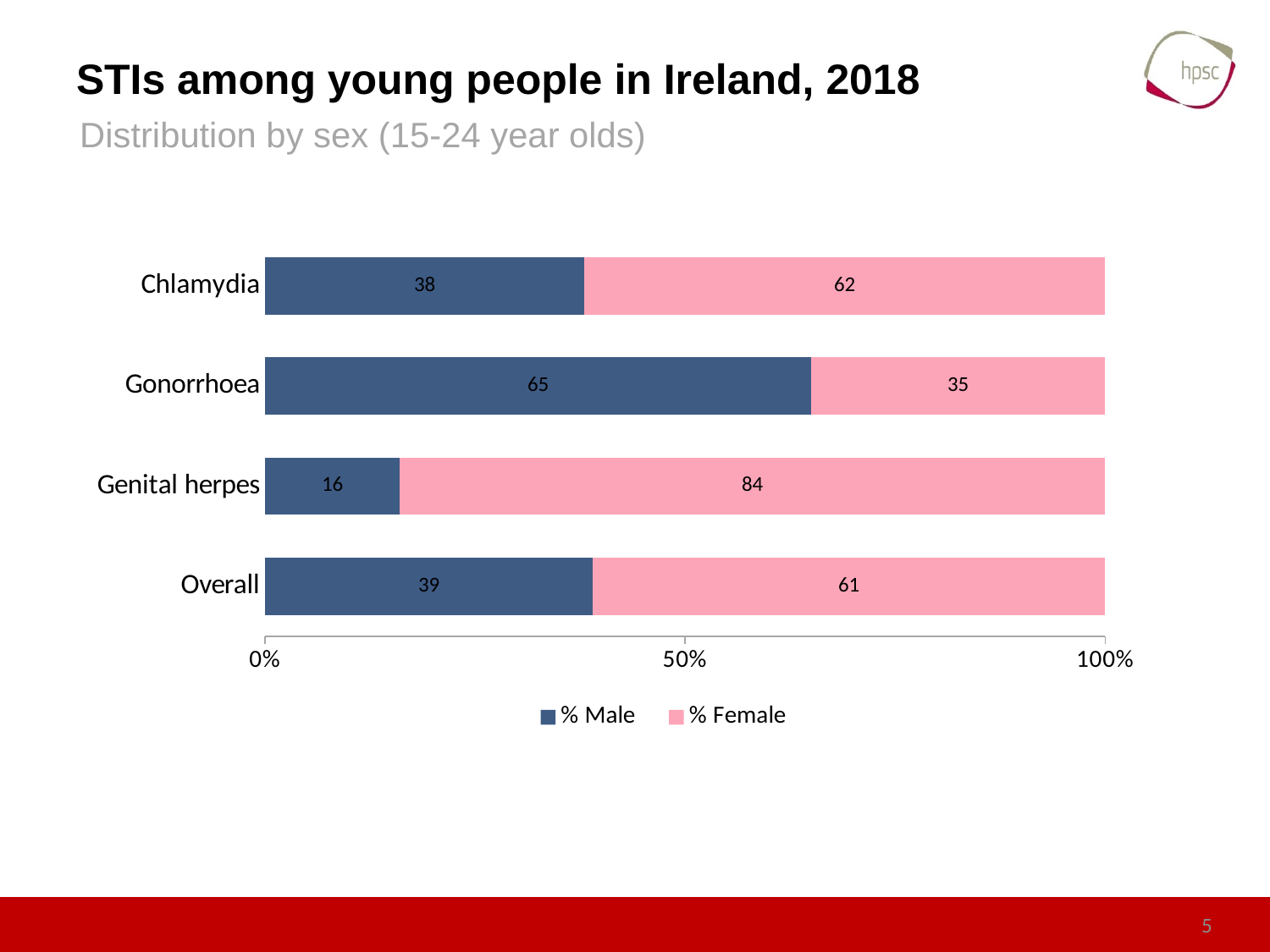
What is the % Male value for Gonorrhoea? 65 How many series does the legend list? 2 Which category has the highest % Male value? Gonorrhoea Which category has the lowest % Female value? Gonorrhoea What kind of chart is shown on the slide? Stacked bar chart Is the % Male value larger for Chlamydia or for Gonorrhoea? Gonorrhoea Is the % Male value for Genital herpes greater or less than 50%? less What is the % Female value for Genital herpes? 84 How many categories are shown on the chart? 4 What is the difference between the % Female and % Male values for Genital herpes? 68 What is the % Female value for Overall? 61 What is the % Male value for Chlamydia? 38